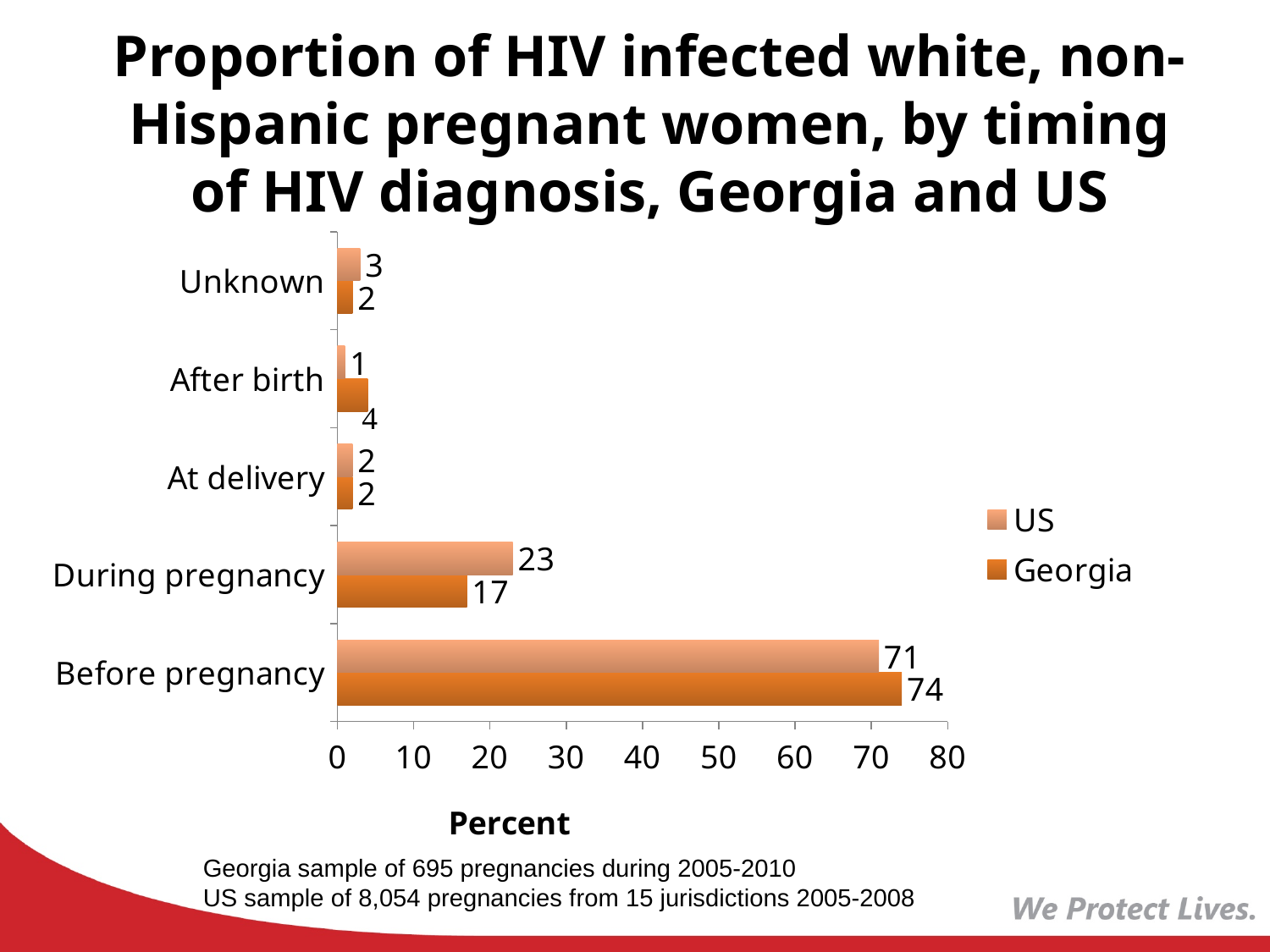
Which is larger for During pregnancy, the US value or the Georgia value? US How many categories are shown on the y axis? 5 How many series does the legend list? 2 What is the difference between the Georgia and US values for Before pregnancy? 3 What kind of chart is shown on the slide? Bar chart What is the Georgia value for After birth? 4 What is the Georgia value for Before pregnancy? 74 What is the US value for Unknown? 3 What is the US value for During pregnancy? 23 What is the difference between the US and Georgia values for During pregnancy? 6 Which category has the highest Georgia value? Before pregnancy Which category has the lowest US value? After birth